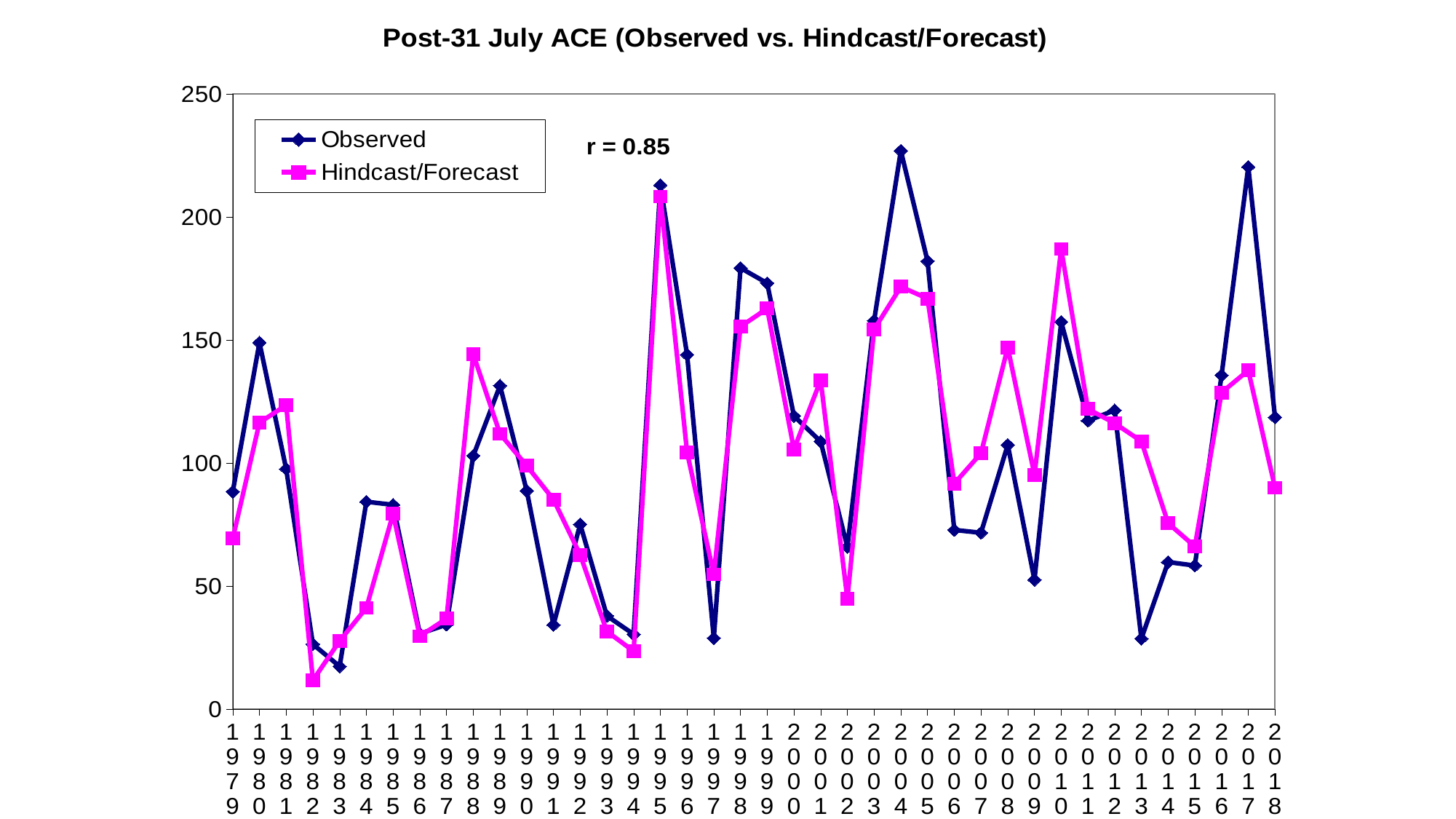
For 2010, which series has the larger value, Observed or Hindcast/Forecast? Hindcast/Forecast In which year does the Hindcast/Forecast series reach its highest value? 1995 How many series does the legend list? 2 What correlation value is printed on the chart? r = 0.85 In which year does the Observed series reach its lowest value? 1983 Is the Observed value for 1995 greater or less than 200? greater For 2017, which series has the larger value, Observed or Hindcast/Forecast? Observed How many years are plotted along the x axis? 40 In which year does the Hindcast/Forecast series reach its lowest value? 1982 What kind of chart is shown on the slide? line chart Is the Hindcast/Forecast value for 2010 greater or less than 150? greater Is the Observed value for 2013 greater or less than 50? less